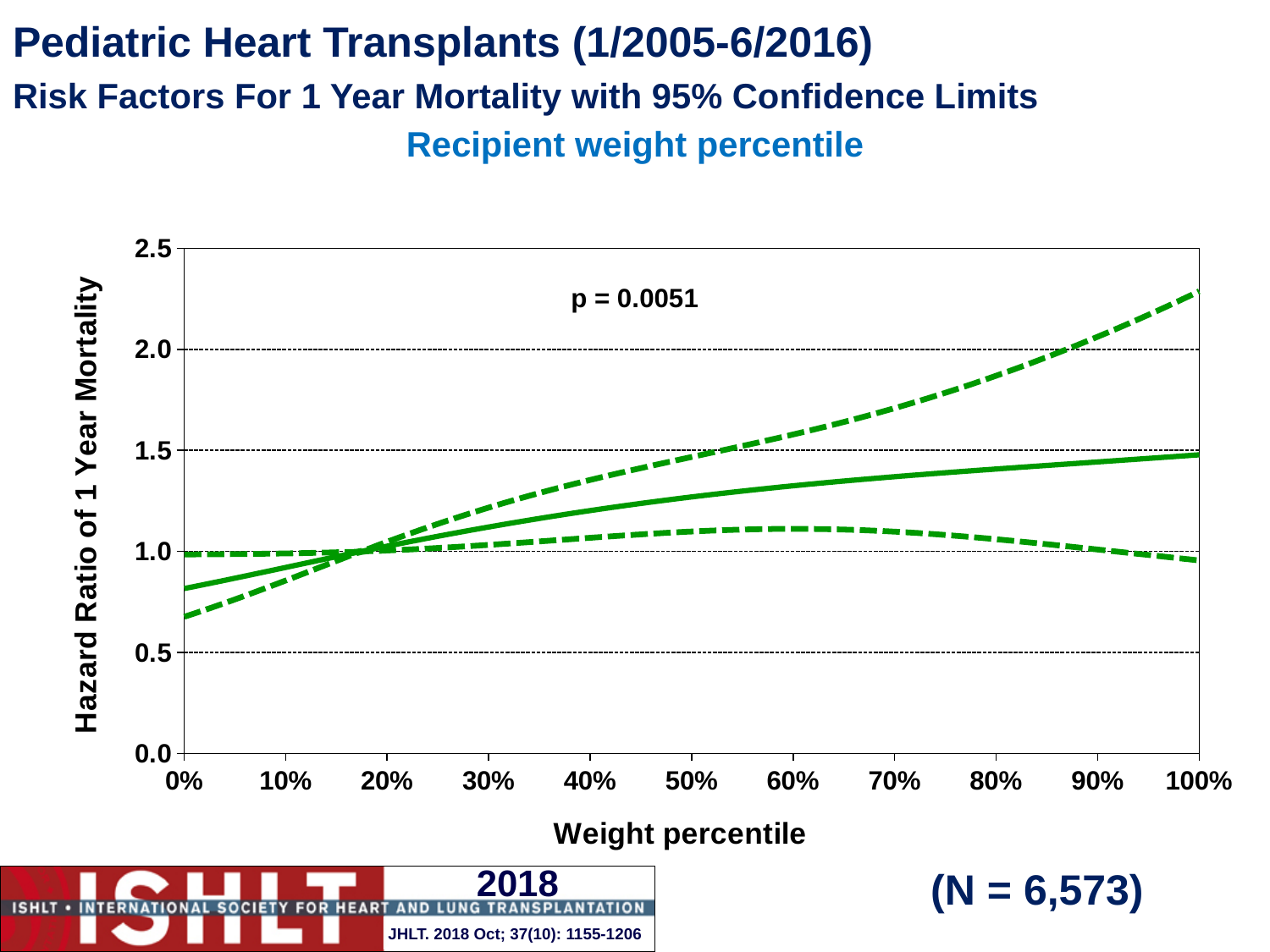
How many lines are plotted on the chart? 3 Is the upper dashed confidence limit at 70% weight percentile greater or less than 1.5? greater What kind of chart is shown on the slide? line chart Is the solid hazard ratio line at 100% weight percentile greater or less than 1.0? greater Is the upper dashed confidence limit at 100% weight percentile greater or less than 2.0? greater What p-value is printed on the chart? p = 0.0051 Does the solid hazard ratio line rise or fall as the weight percentile increases from 0% to 100%? rise What is the label of the y axis? Hazard Ratio of 1 Year Mortality